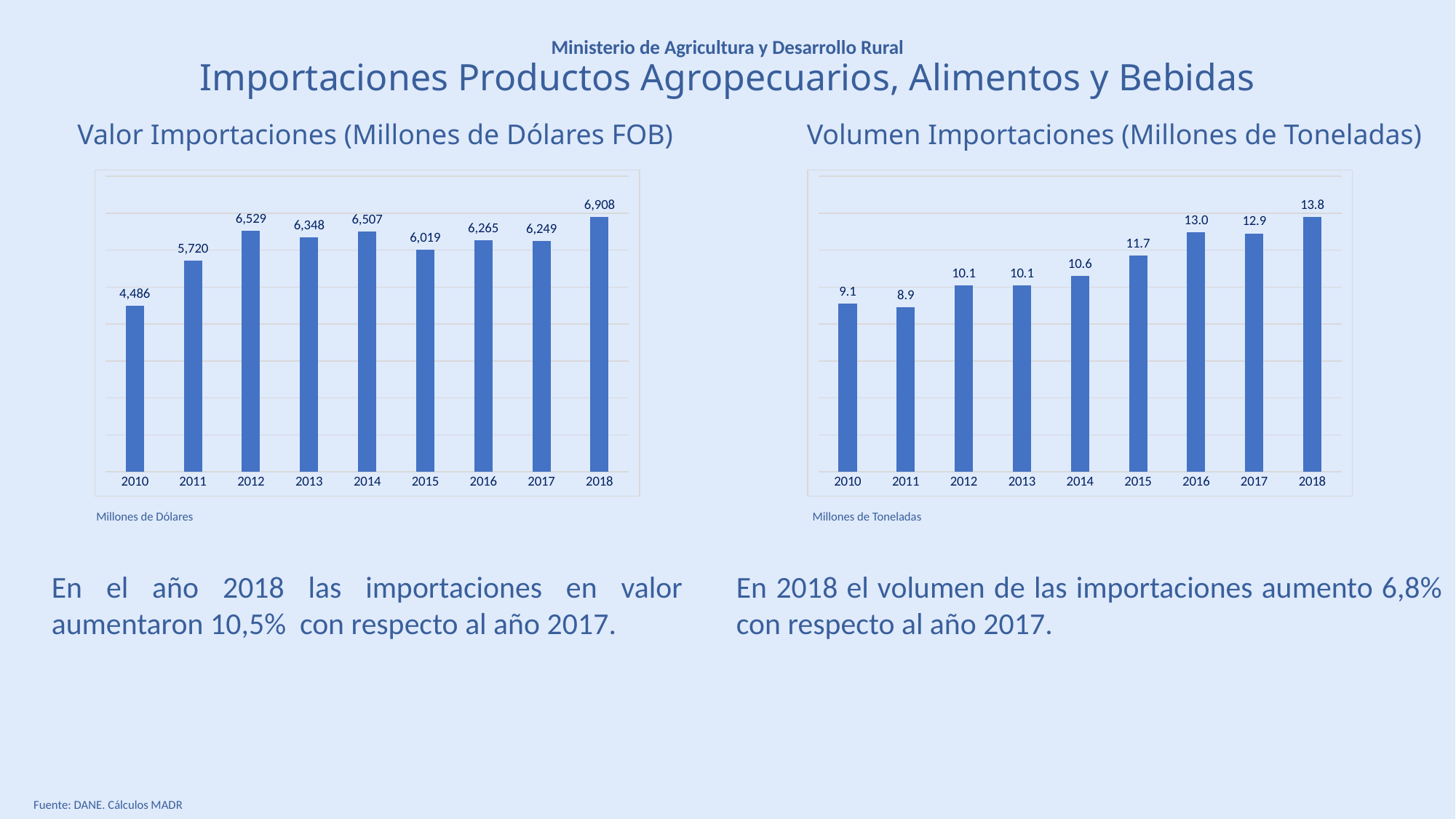
In the 'Valor Importaciones (Millones de Dólares FOB)' chart, which year has the lowest value? 2010 What kind of chart is the 'Volumen Importaciones (Millones de Toneladas)' chart? Bar chart In the 'Valor Importaciones (Millones de Dólares FOB)' chart, which is larger, the value for 2012 or the value for 2014? 2012 In the 'Volumen Importaciones (Millones de Toneladas)' chart, which year has the lowest value? 2011 In the 'Valor Importaciones (Millones de Dólares FOB)' chart, what is the value for 2010? 4,486 In the 'Valor Importaciones (Millones de Dólares FOB)' chart, what is the difference between the values for 2018 and 2017? 659 In the 'Volumen Importaciones (Millones de Toneladas)' chart, what is the value for 2015? 11.7 In the 'Valor Importaciones (Millones de Dólares FOB)' chart, which year has the highest value? 2018 In the 'Volumen Importaciones (Millones de Toneladas)' chart, what is the difference between the values for 2018 and 2010? 4.7 What is the title of the chart on the left side of the slide? Valor Importaciones (Millones de Dólares FOB) How many years are shown in the 'Valor Importaciones (Millones de Dólares FOB)' chart? 9 In the 'Volumen Importaciones (Millones de Toneladas)' chart, do the values generally rise or fall from 2010 to 2018? Rise